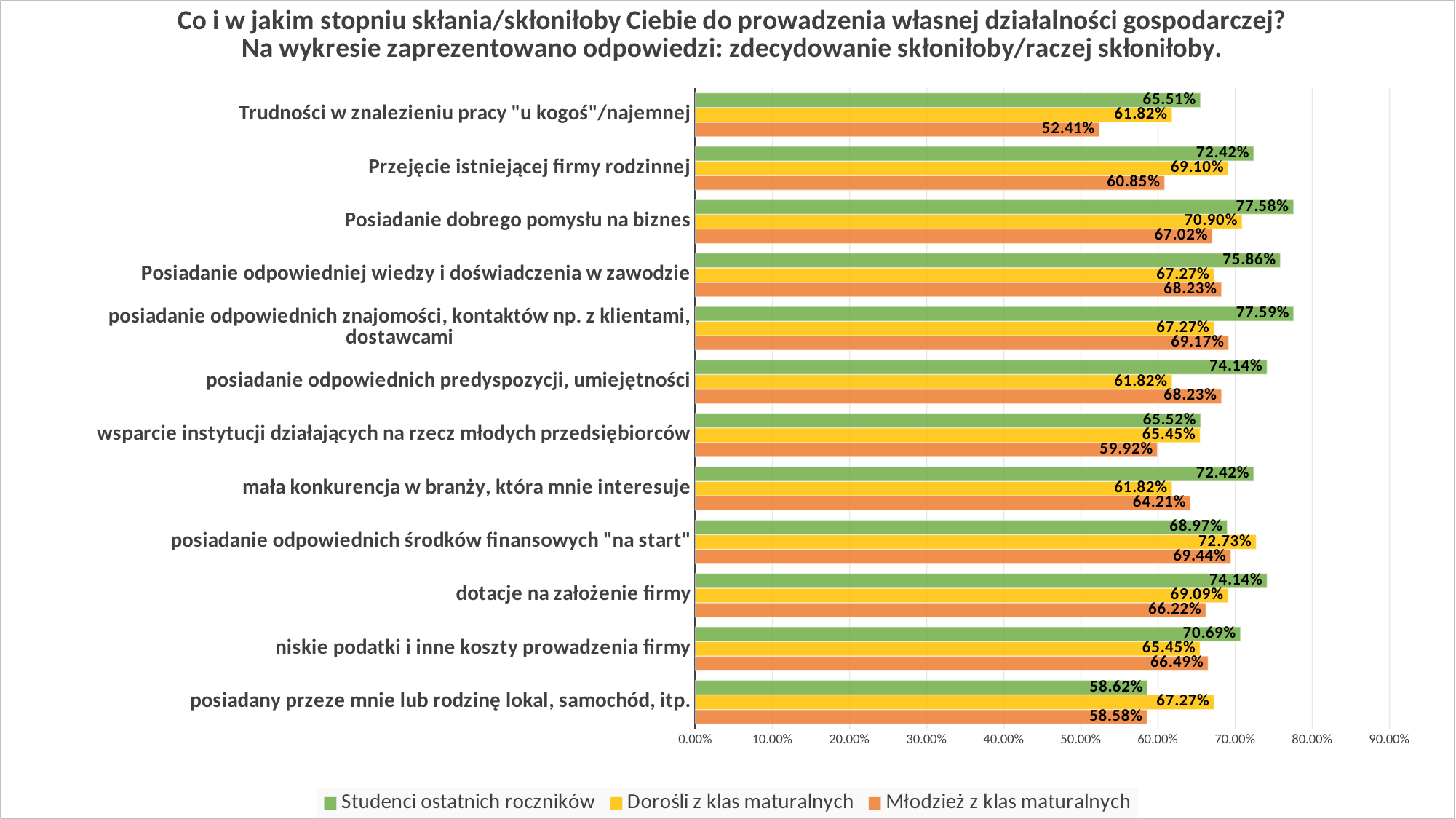
How many series does the legend list? 3 Which colour represents Młodzież z klas maturalnych in the legend? Orange For 'posiadany przeze mnie lub rodzinę lokal, samochód, itp.', which is larger: the value for Dorośli z klas maturalnych or for Studenci ostatnich roczników? Dorośli z klas maturalnych What is the difference between the Studenci ostatnich roczników and Młodzież z klas maturalnych values for 'Trudności w znalezieniu pracy "u kogoś"/najemnej'? 13.10% What is the value for Studenci ostatnich roczników for 'Posiadanie dobrego pomysłu na biznes'? 77.58% Is the value for Studenci ostatnich roczników for 'dotacje na założenie firmy' greater or less than 70.00%? greater What is the value for Dorośli z klas maturalnych for 'posiadanie odpowiednich środków finansowych "na start"'? 72.73% Which category has the lowest value for Młodzież z klas maturalnych? Trudności w znalezieniu pracy "u kogoś"/najemnej How many categories are shown on the chart? 12 Which category has the highest value for Dorośli z klas maturalnych? posiadanie odpowiednich środków finansowych "na start" What is the value for Młodzież z klas maturalnych for 'Trudności w znalezieniu pracy "u kogoś"/najemnej'? 52.41% What type of chart is shown on the slide? Bar chart